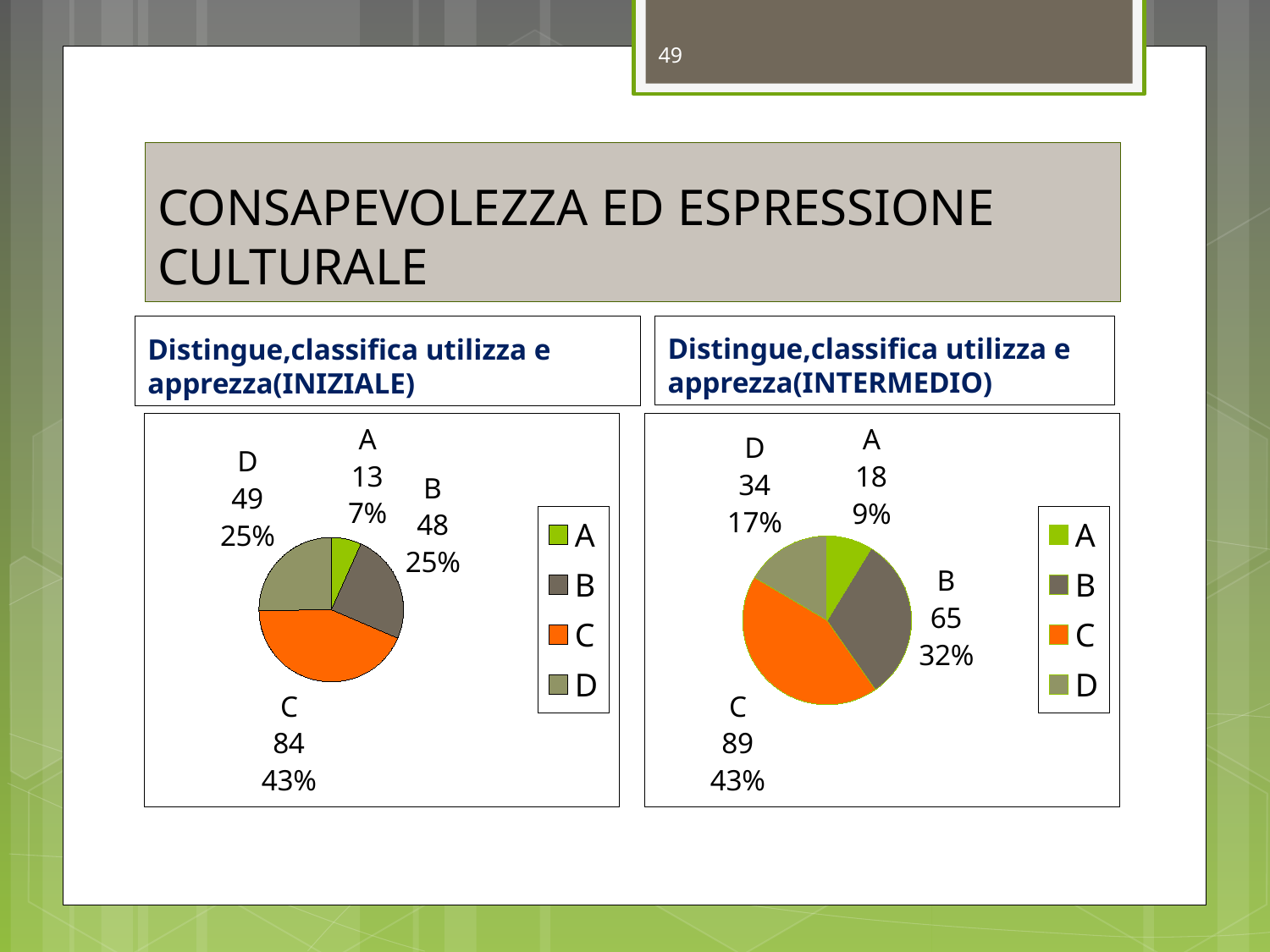
In the INTERMEDIO pie chart on the right, which category has the largest slice? C In the INIZIALE pie chart on the left, which colour represents category C in the legend? Orange In the INTERMEDIO pie chart on the right, what is the value for B? 65 How many categories does the INTERMEDIO pie chart on the right show? 4 In the INIZIALE pie chart on the left, what percentage share does A have? 7% In the INIZIALE pie chart on the left, what is the difference between the values for C and A? 71 What type of chart is used in the INIZIALE chart on the left? Pie chart In the INIZIALE pie chart on the left, what is the value for C? 84 In the INIZIALE pie chart on the left, which category has the smallest slice? A In the INTERMEDIO pie chart on the right, what percentage share does D have? 17% In the INTERMEDIO pie chart on the right, what is the difference between the values for C and D? 55 In the INTERMEDIO pie chart on the right, which is larger, the value for B or the value for D? B